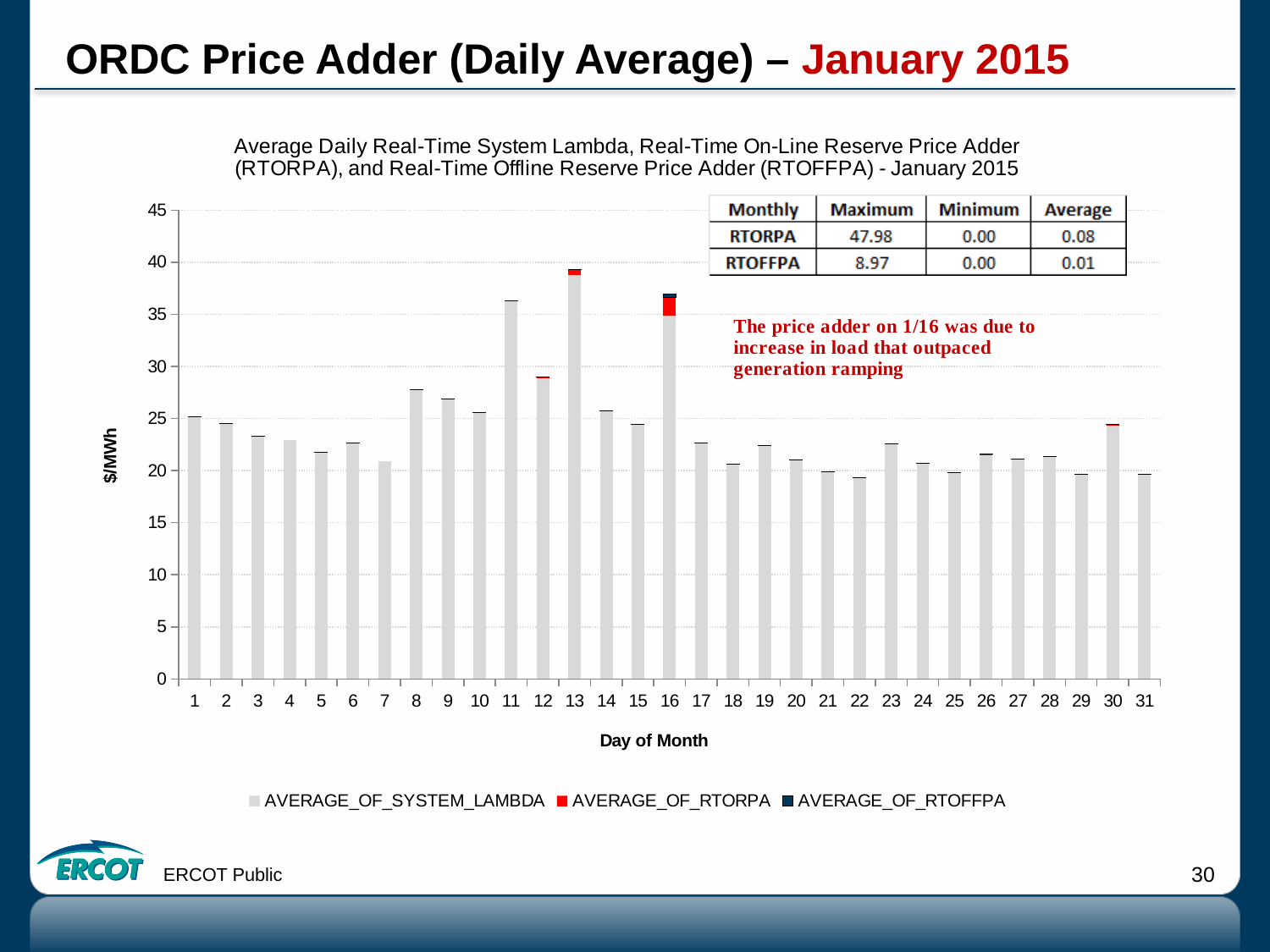
Is the value for day 7 greater or less than 25? less Which day of the month has the tallest bar? 13 What kind of chart is shown on the slide? bar chart How many days of the month are plotted along the x axis? 31 Is the value for day 8 greater or less than 25? greater Which bar is taller, day 11 or day 13? 13 Is the value for day 22 greater or less than 20? less According to the table on the chart, what is the monthly maximum RTORPA? 47.98 How many series does the legend list? 3 Which bar is taller, day 2 or day 5? 2 What is the label on the y axis of the chart? $/MWh